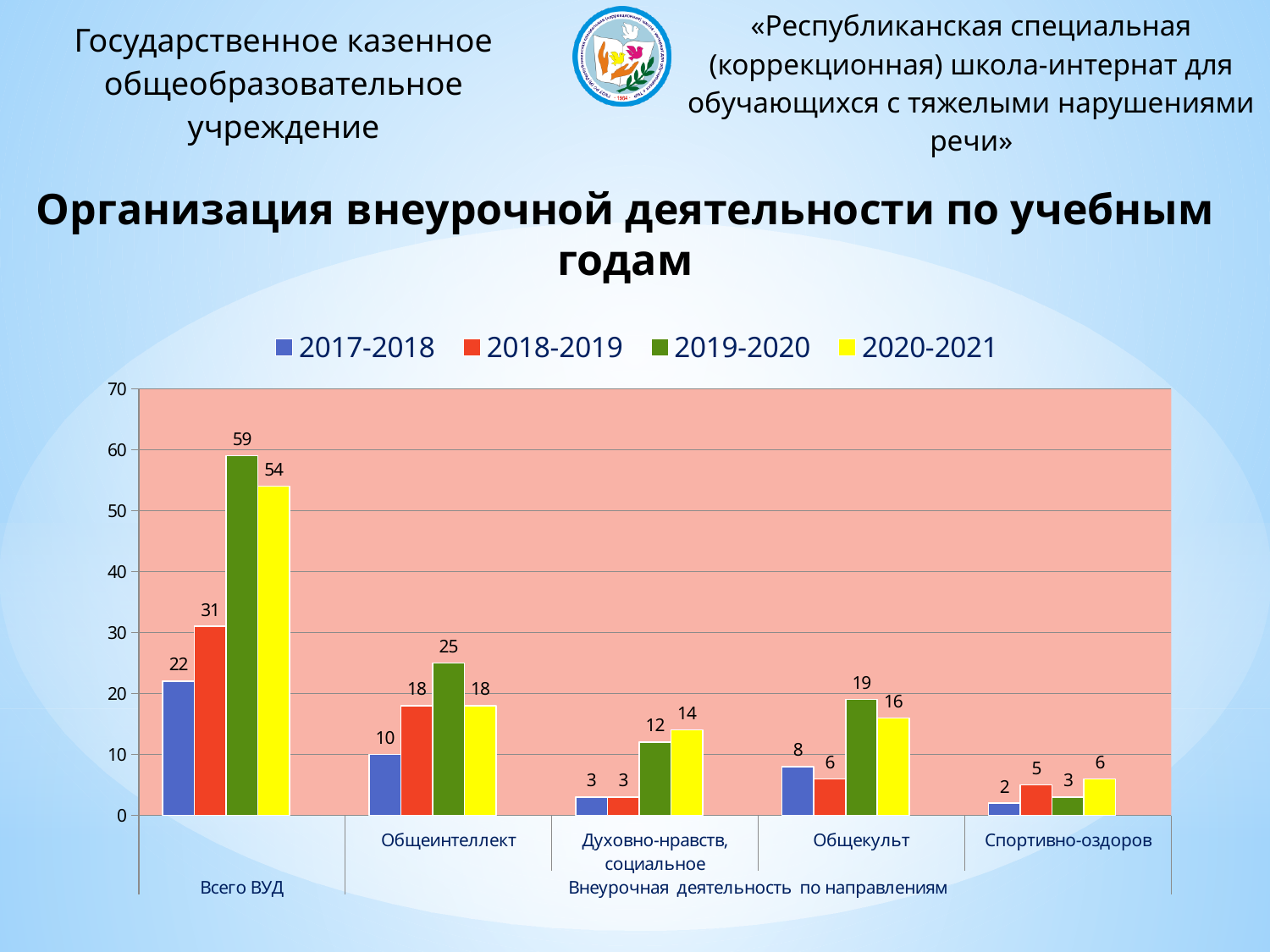
What is the value for 2017-2018 in the Общеинтеллект category? 10 What is the value for 2020-2021 in the Духовно-нравств, социальное category? 14 Which is larger in the Общекульт category: the value for 2017-2018 or the value for 2018-2019? 2017-2018 Which colour represents the 2020-2021 series in the legend? Yellow What is the value for 2019-2020 in the Всего ВУД category? 59 Which series has the highest value in the Общекульт category? 2019-2020 What is the difference between the 2019-2020 and 2017-2018 values in the Всего ВУД category? 37 Which series has the lowest value in the Спортивно-оздоров category? 2017-2018 How many categories are shown on the x axis? 5 Is the value for 2018-2019 in the Всего ВУД category greater or less than 30? greater How many series does the legend list? 4 What kind of chart is shown on the slide? Bar chart